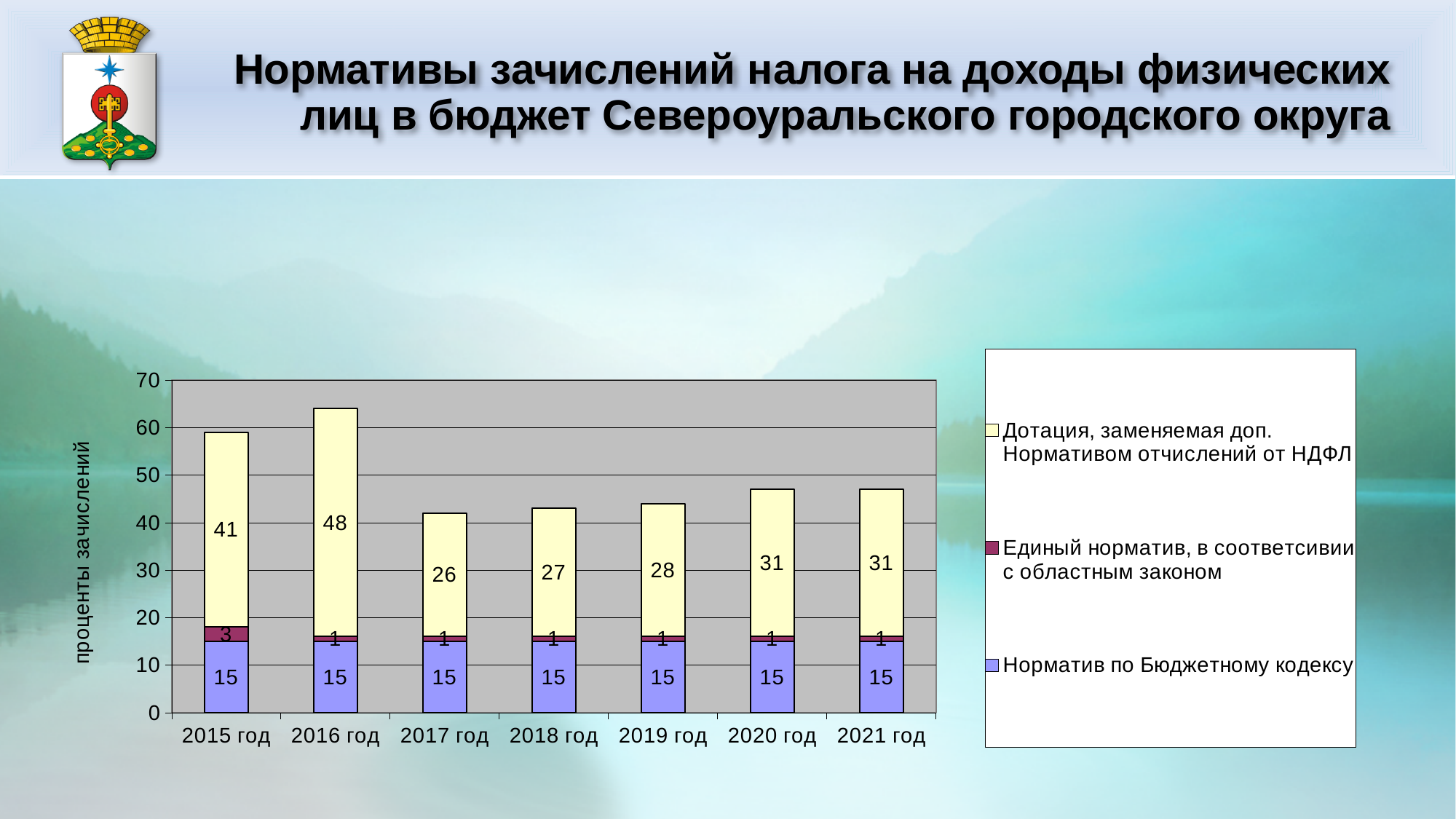
What is the label of the y axis? проценты зачислений How many series does the legend list? 3 What is the total of the stacked bar for 2015 год? 59 In which year is the 'Дотация, заменяемая доп. Нормативом отчислений от НДФЛ' value highest? 2016 год Which is larger: the 'Дотация, заменяемая доп. Нормативом отчислений от НДФЛ' value for 2015 год or for 2020 год? 2015 год In which year is the 'Дотация, заменяемая доп. Нормативом отчислений от НДФЛ' value lowest? 2017 год What is the value of 'Норматив по Бюджетному кодексу' for 2019 год? 15 What is the difference between the 'Дотация, заменяемая доп. Нормативом отчислений от НДФЛ' values for 2016 год and 2017 год? 22 What type of chart is shown on the slide? stacked bar chart What is the value of 'Дотация, заменяемая доп. Нормативом отчислений от НДФЛ' for 2016 год? 48 What is the value of 'Единый норматив, в соответсивии с областным законом' for 2015 год? 3 How many years are shown on the x axis? 7